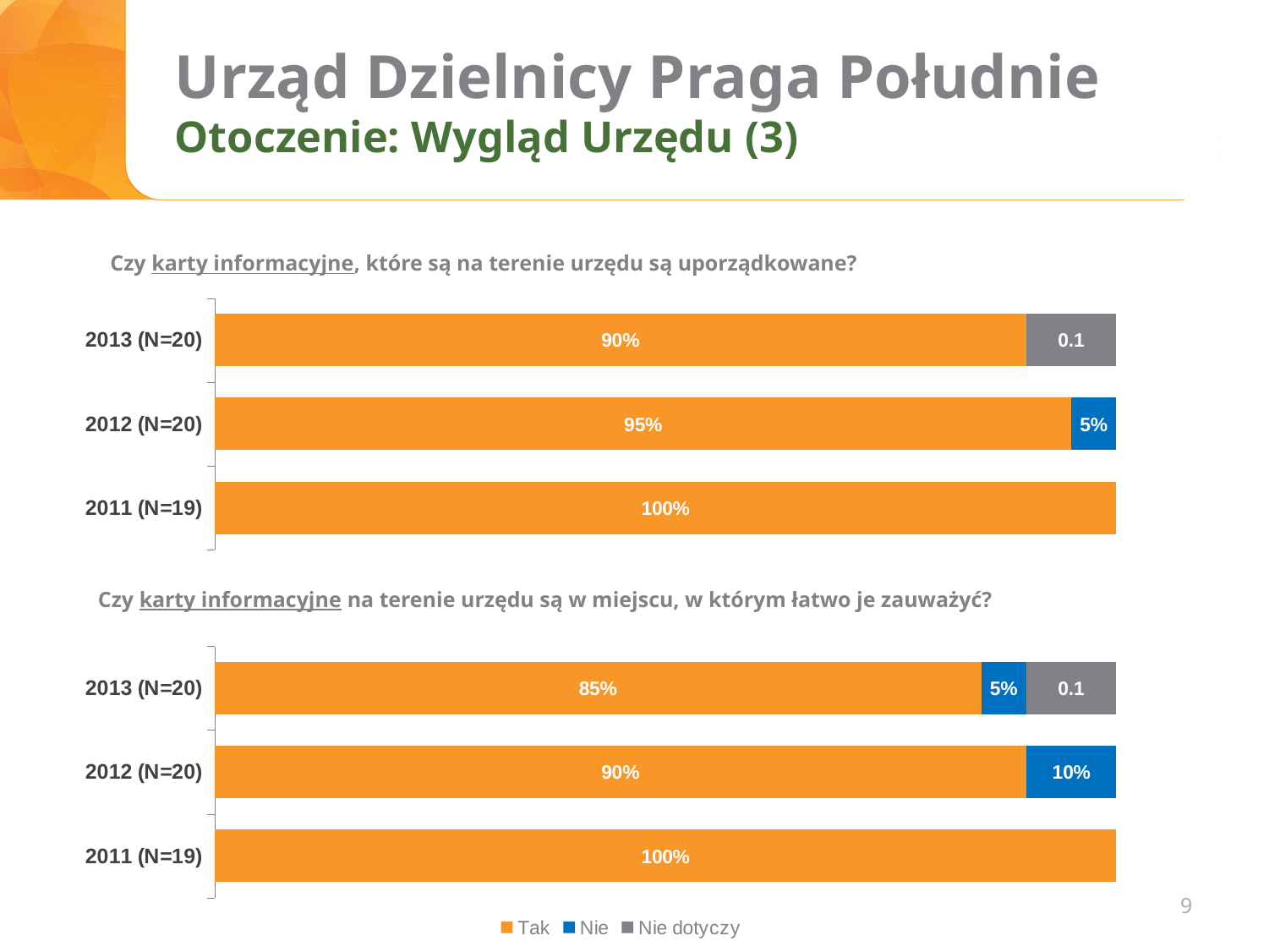
In the top chart, which year has the highest 'Tak' value? 2011 (N=19) How many year categories does the bottom chart show? 3 In the bottom chart, which year has the lowest 'Tak' value? 2013 (N=20) In the top chart, what is the 'Tak' value for 2013 (N=20)? 90% How many series does the legend list? 3 In the top chart, what is the 'Nie' value for 2012 (N=20)? 5% In the bottom chart, what is the 'Tak' value for 2013 (N=20)? 85% In the bottom chart, what is the 'Nie' value for 2012 (N=20)? 10% In the bottom chart, what is the difference between the 'Tak' values for 2011 (N=19) and 2013 (N=20)? 15% In the top chart, is the 'Tak' value for 2012 (N=20) larger or smaller than the 'Tak' value for 2013 (N=20)? larger In the top chart, what is the 'Tak' value for 2011 (N=19)? 100% What type of chart is the top chart? stacked bar chart